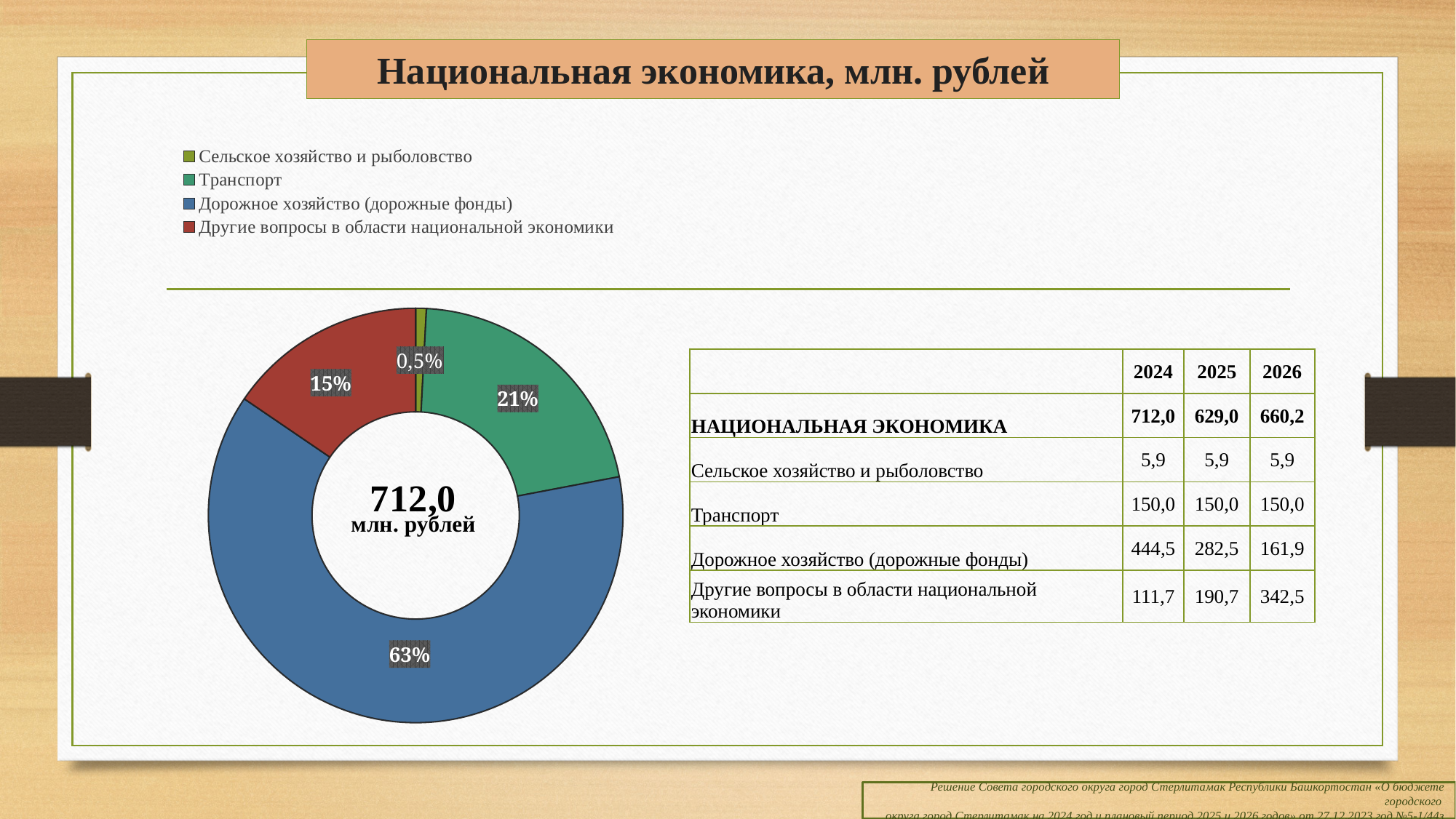
What colour is the slice for Дорожное хозяйство (дорожные фонды) in the pie chart? Blue Which slice is larger in the pie chart: Транспорт or Другие вопросы в области национальной экономики? Транспорт Which category has the largest slice in the pie chart? Дорожное хозяйство (дорожные фонды) What is the difference in percentage points between the Дорожное хозяйство (дорожные фонды) slice and the Транспорт slice? 42 percentage points What share of the pie chart does Транспорт take? 21% How many categories does the pie chart show? 4 What kind of chart is shown on the slide? Pie (donut) chart What share of the pie chart does Сельское хозяйство и рыболовство take? 0,5% What total value is printed in the centre of the pie chart? 712,0 млн. рублей Which category has the smallest slice in the pie chart? Сельское хозяйство и рыболовство What share of the pie chart does Дорожное хозяйство (дорожные фонды) take? 63%